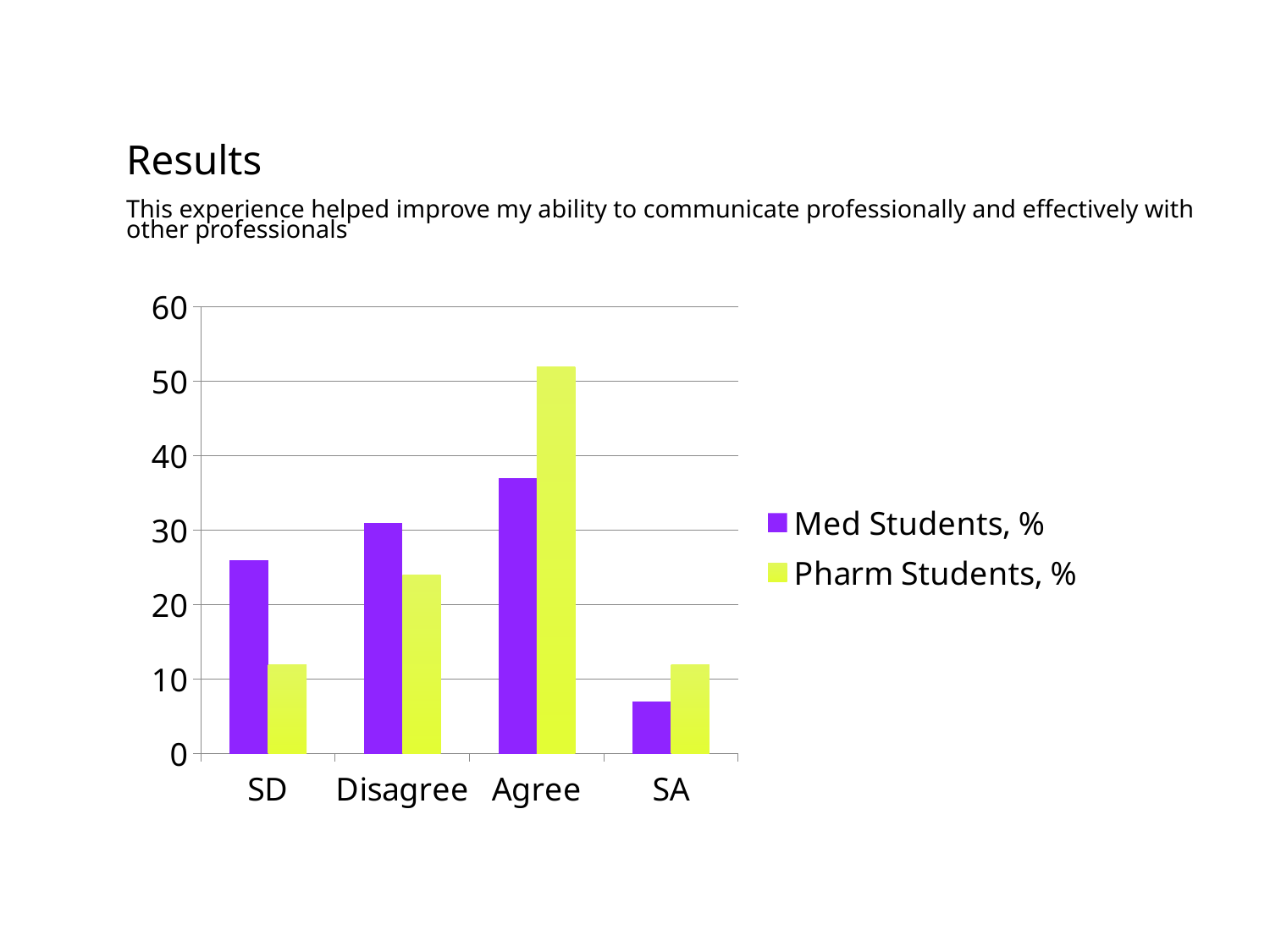
How many series does the legend list? 2 How many categories are shown on the x axis? 4 For the SD category, which series has the larger value, Med Students, % or Pharm Students, %? Med Students, % Which category has the highest value for Med Students, %? Agree Which category has the highest value for Pharm Students, %? Agree Which series is shown in purple in the legend? Med Students, % Is the value for Med Students, % in the SA category greater or less than 10? less For the Agree category, which series has the larger value, Med Students, % or Pharm Students, %? Pharm Students, % Is the value for Med Students, % in the Agree category greater or less than 40? less Is the value for Pharm Students, % in the Disagree category greater or less than 20? greater What kind of chart is shown on the slide? bar chart Which category has the lowest value for Med Students, %? SA